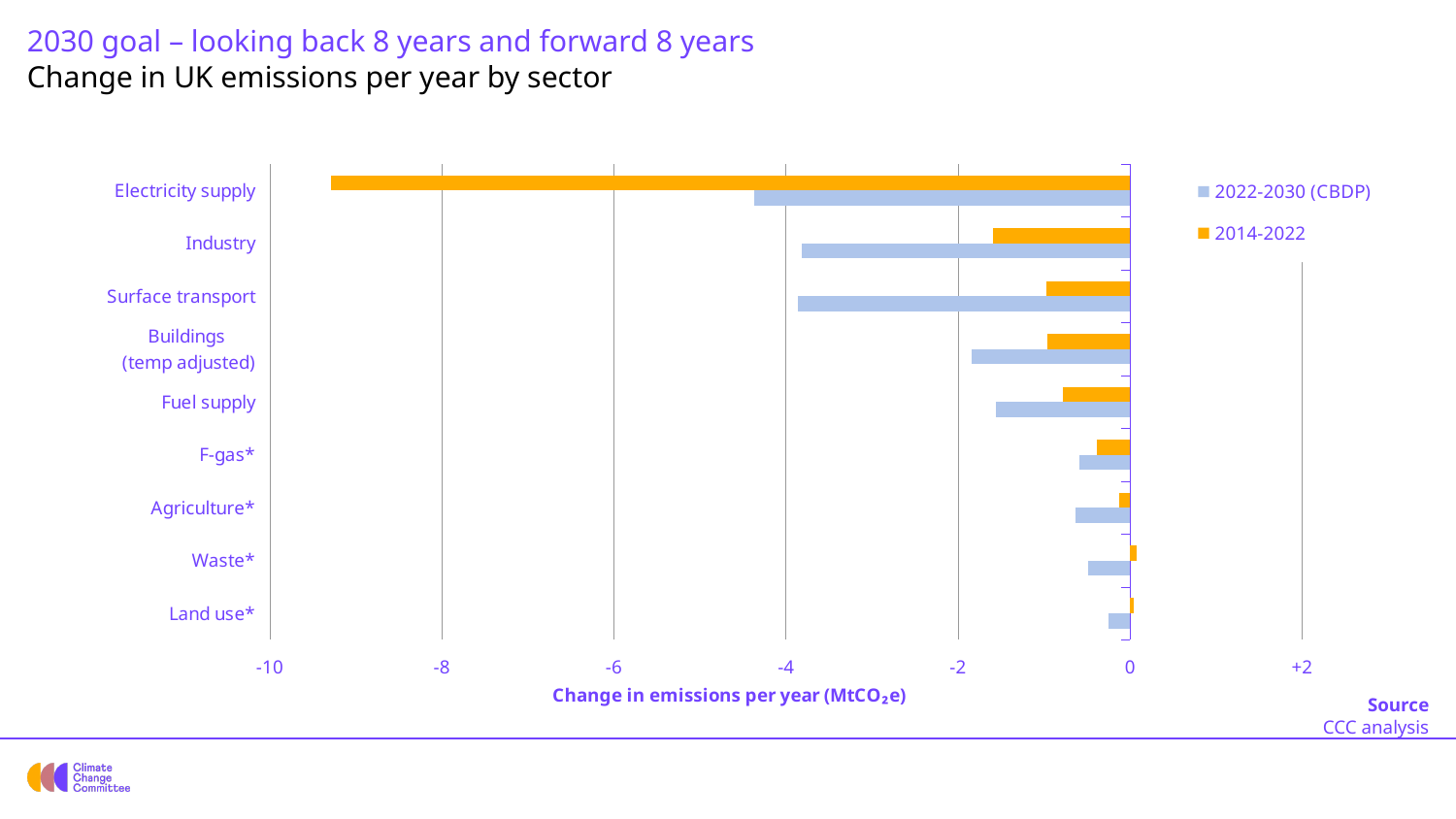
For Industry, which series shows the larger emissions reduction per year: 2014-2022 or 2022-2030 (CBDP)? 2022-2030 (CBDP) Is the 2014-2022 value for Industry greater or less than -2? greater Which sector has the largest emissions reduction per year in the 2014-2022 series? Electricity supply Is the 2014-2022 value for Waste* greater or less than 0? greater What is the title of the horizontal axis? Change in emissions per year (MtCO2e) Is the 2022-2030 (CBDP) value for Electricity supply greater or less than -4? less Which sector has the largest emissions reduction per year in the 2022-2030 (CBDP) series? Electricity supply How many sectors are listed on the chart? 9 What kind of chart is shown on the slide? Bar chart How many series does the legend list? 2 Which sector has the smallest change in emissions per year in the 2022-2030 (CBDP) series? Land use*